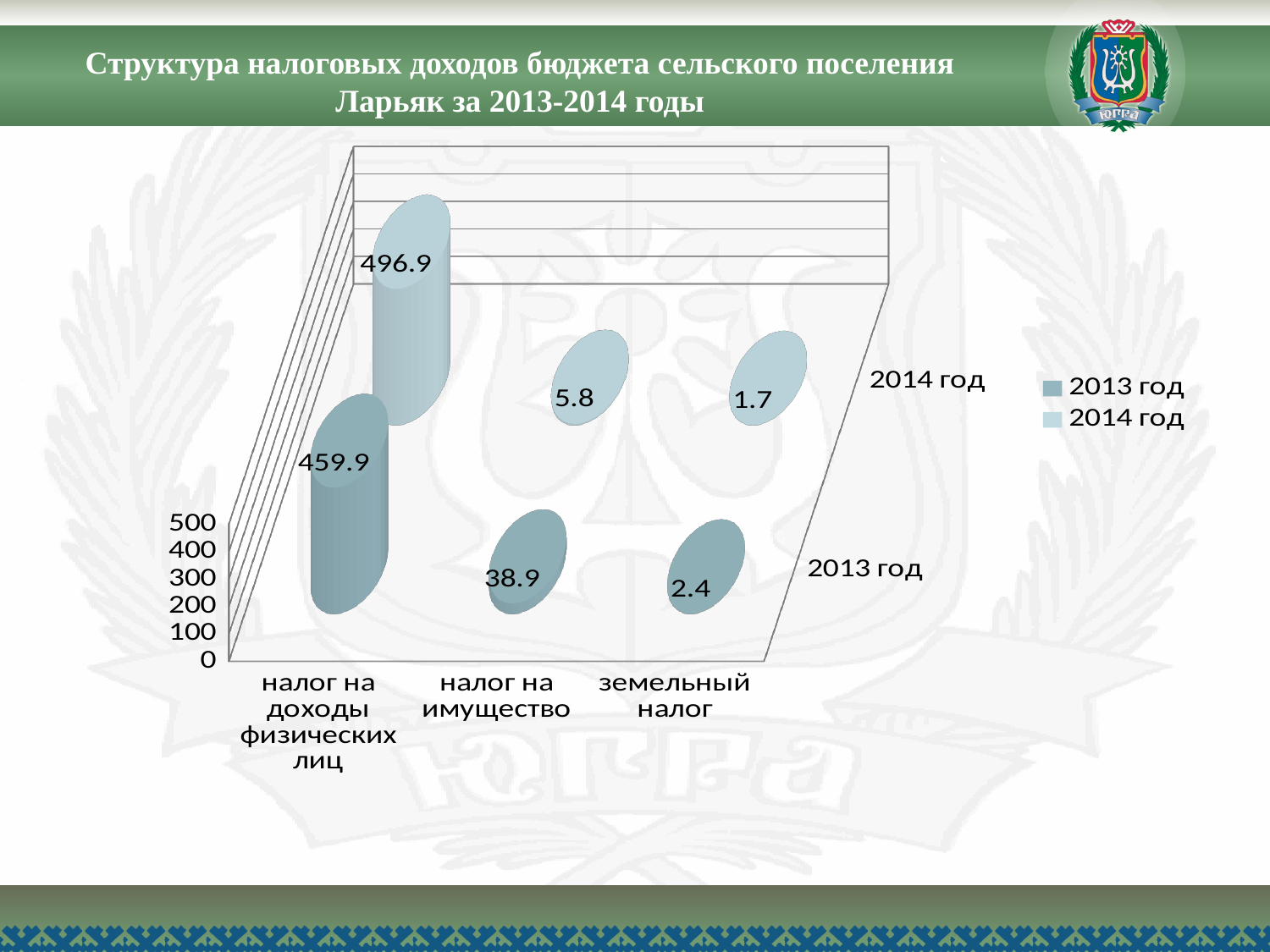
Which category has the highest value in 2014 год? налог на доходы физических лиц How many categories are shown on the x axis? 3 How many series does the legend list? 2 What is the value for налог на доходы физических лиц in 2014 год? 496.9 Which is larger for налог на имущество: the 2013 год value or the 2014 год value? 2013 год What kind of chart is shown on the slide? bar chart What is the difference between the 2014 год and 2013 год values for налог на доходы физических лиц? 37.0 What is the value for налог на доходы физических лиц in 2013 год? 459.9 What is the value for налог на имущество in 2013 год? 38.9 What is the value for земельный налог in 2014 год? 1.7 Which category has the lowest value in 2013 год? земельный налог What is the difference between the 2013 год values for налог на имущество and земельный налог? 36.5